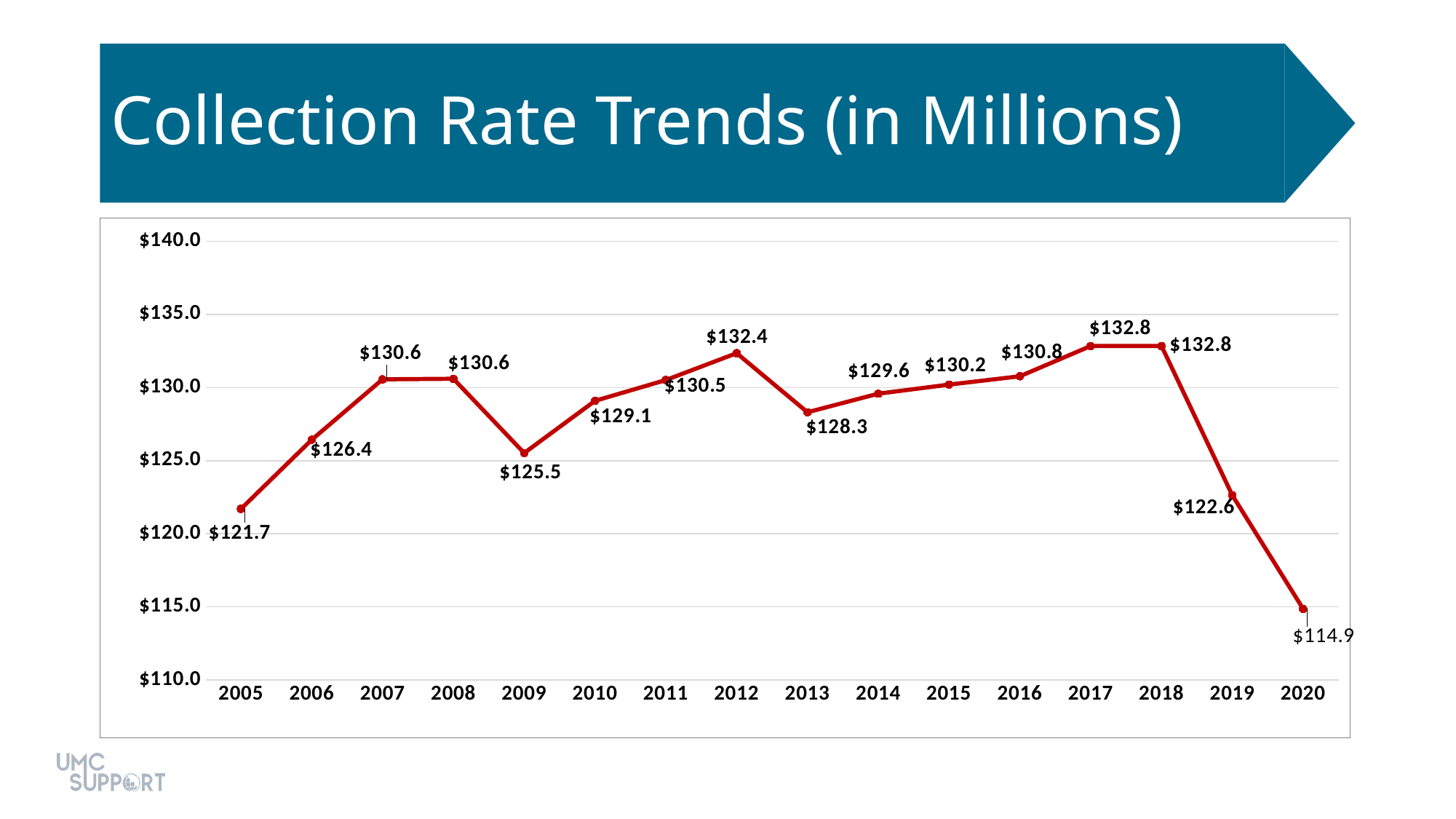
Do the values rise or fall from 2018 to 2020? Fall What kind of chart is shown on the slide? Line chart Which years share the highest value on the chart? 2017 and 2018 What is the value for 2009? $125.5 What is the difference between the values for 2012 and 2013? $4.1 Which is larger, the value for 2006 or the value for 2010? 2010 Which year has the lowest value? 2020 What is the difference between the values for 2019 and 2020? $7.7 What is the value for 2005? $121.7 What is the value for 2012? $132.4 How many years are plotted on the chart? 16 What is the value for 2020? $114.9